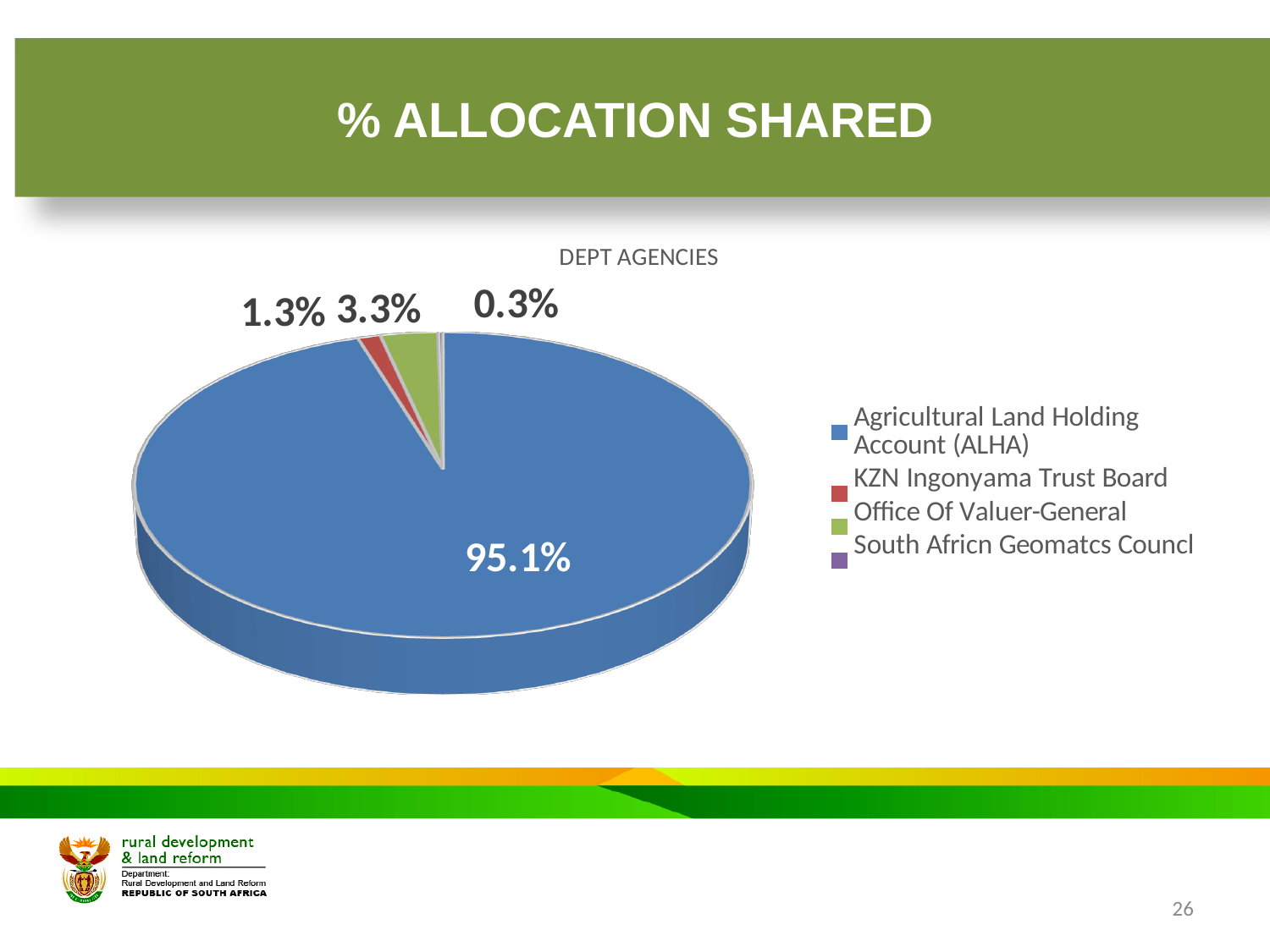
What kind of chart is shown on the slide? pie chart What is the title of the chart? DEPT AGENCIES How many slices does the pie chart have? 4 What percentage share does Agricultural Land Holding Account (ALHA) have? 95.1% Which agency has the smallest share of the pie? South Africn Geomatcs Councl What colour is the slice for Agricultural Land Holding Account (ALHA)? blue What is the difference between the share for Office Of Valuer-General and the share for KZN Ingonyama Trust Board? 2.0% What percentage share does KZN Ingonyama Trust Board have? 1.3% What percentage share does Office Of Valuer-General have? 3.3% Which agency has the largest share of the pie? Agricultural Land Holding Account (ALHA) Which is larger, the share for Office Of Valuer-General or the share for KZN Ingonyama Trust Board? Office Of Valuer-General What percentage share does South Africn Geomatcs Councl have? 0.3%